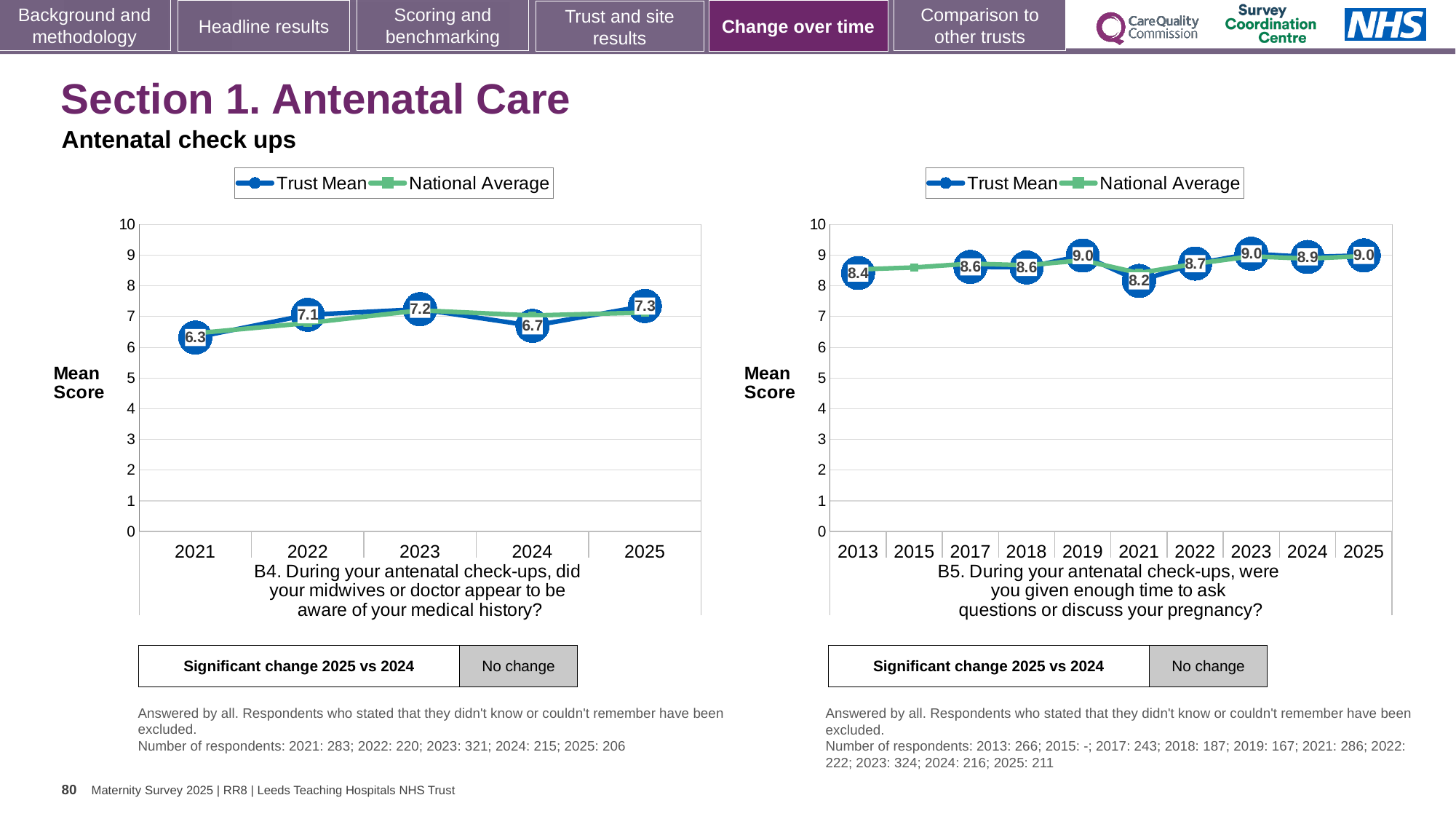
On the left chart (B4), which year has the highest Trust Mean score? 2025 On the left chart (B4), what is the Trust Mean score for 2021? 6.3 On the left chart (B4), how many years are shown on the x axis? 5 What kind of chart is the left chart (B4)? line chart On the left chart (B4), which year has the lowest Trust Mean score? 2021 On the right chart (B5), what is the Trust Mean score for 2021? 8.2 On the right chart (B5), how many series does the legend list? 2 On the left chart (B4), what is the difference between the Trust Mean scores for 2025 and 2021? 1.0 On the right chart (B5), what is the Trust Mean score for 2024? 8.9 On the left chart (B4), what is the Trust Mean score for 2024? 6.7 On the right chart (B5), which year has the lowest Trust Mean score? 2021 On the right chart (B5), is the Trust Mean score for 2013 larger or smaller than the score for 2022? smaller